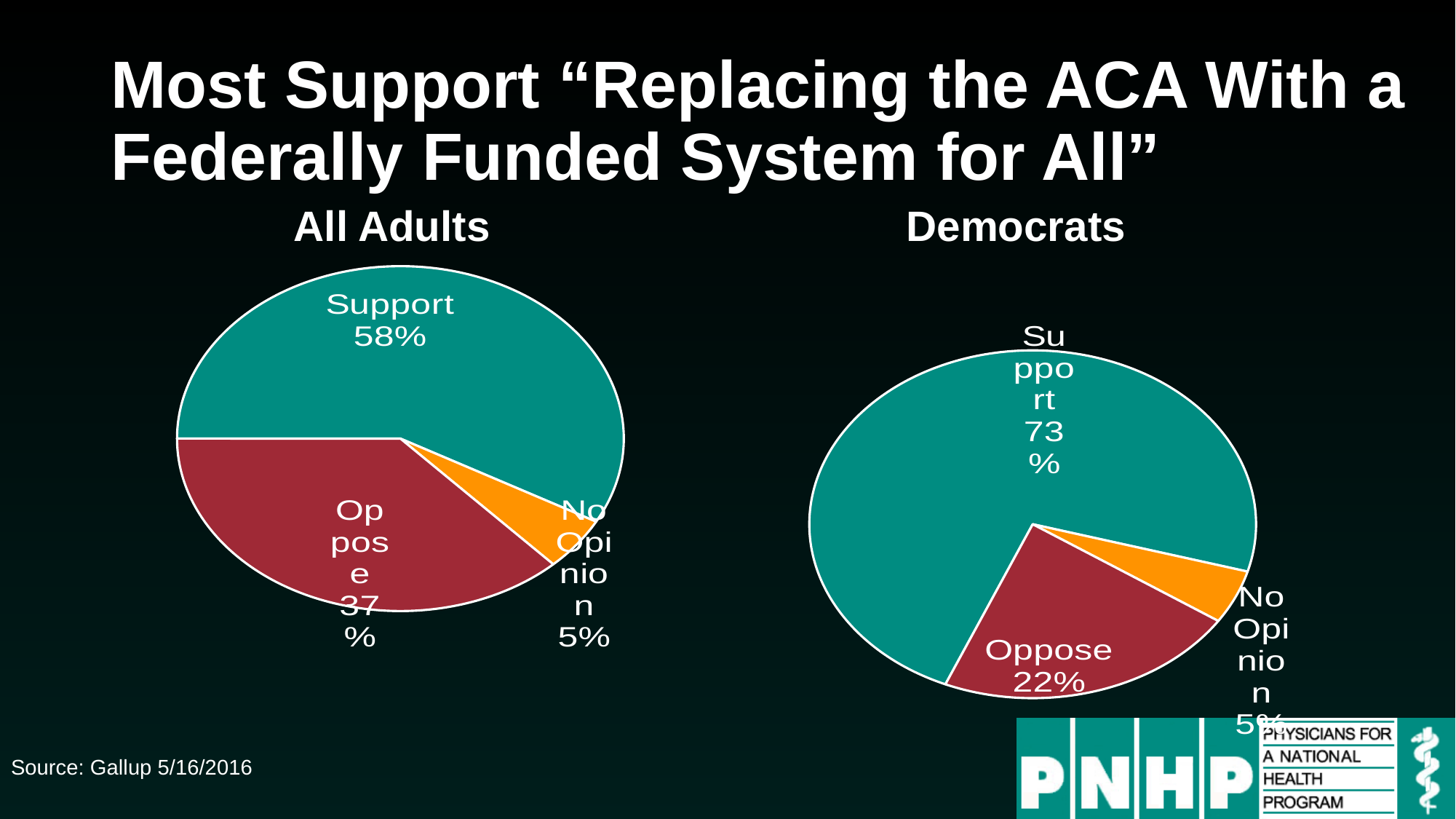
In the All Adults chart, what percentage of respondents support replacing the ACA with a federally funded system for all? 58% What type of chart is used for the Democrats data? Pie chart In the All Adults chart, what percentage have no opinion? 5% In the All Adults chart, what percentage oppose? 37% In the Democrats chart, what percentage support? 73% In the All Adults chart, which response has the largest share? Support What is the difference in percentage points between Support and Oppose in the All Adults chart? 21 Which is larger: the Oppose share in the All Adults chart or the Oppose share in the Democrats chart? All Adults How many slices does the All Adults chart have? 3 How many percentage points higher is Support among Democrats than among All Adults? 15 In the Democrats chart, what percentage oppose? 22% In the Democrats chart, which response has the smallest share? No Opinion